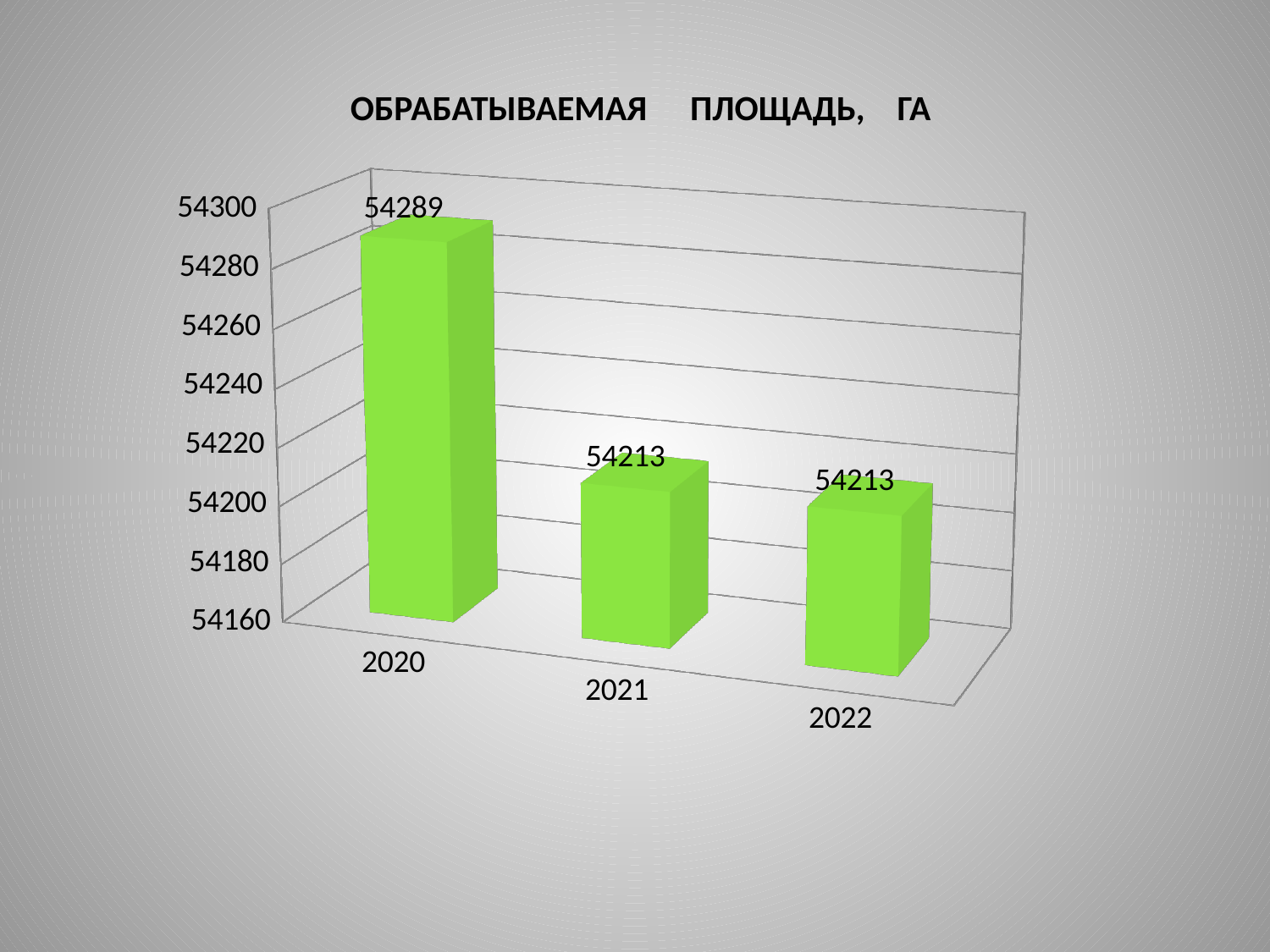
Which is larger, the value for 2020 or the value for 2022? 2020 What is the title of the chart? ОБРАБАТЫВАЕМАЯ ПЛОЩАДЬ, ГА What is the value for 2021? 54213 How many years are shown on the chart? 3 Do the values rise or fall from 2020 to 2021? fall What kind of chart is this? bar chart Which year has the highest value? 2020 What is the value for 2020? 54289 Is the value for 2021 greater or less than 54240? less What is the difference between the values for 2020 and 2021? 76 What is the value for 2022? 54213 Is the value for 2020 greater or less than 54260? greater